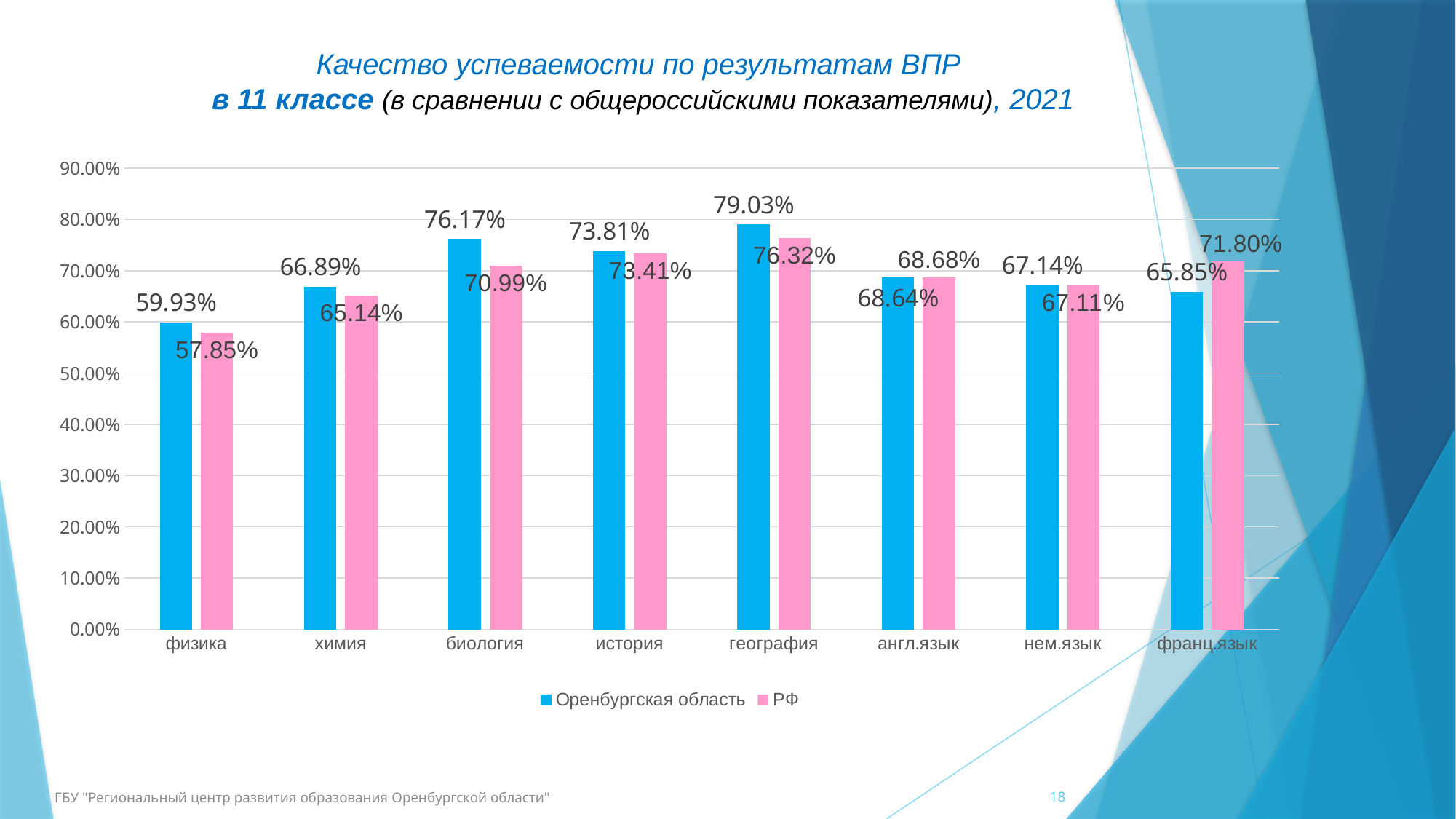
What is the difference between the Оренбургская область and РФ values for биология? 5.18% What is the difference between the РФ and Оренбургская область values for франц.язык? 5.95% Which subject has the lowest value for РФ? физика What is the value for РФ in физика? 57.85% What is the value for Оренбургская область in биология? 76.17% How many subjects are shown on the x axis? 8 For франц.язык, which is larger: Оренбургская область or РФ? РФ For география, which is larger: Оренбургская область or РФ? Оренбургская область How many series does the legend list? 2 What is the value for РФ in франц.язык? 71.80% Which subject has the highest value for Оренбургская область? география What kind of chart is shown on the slide? Bar chart